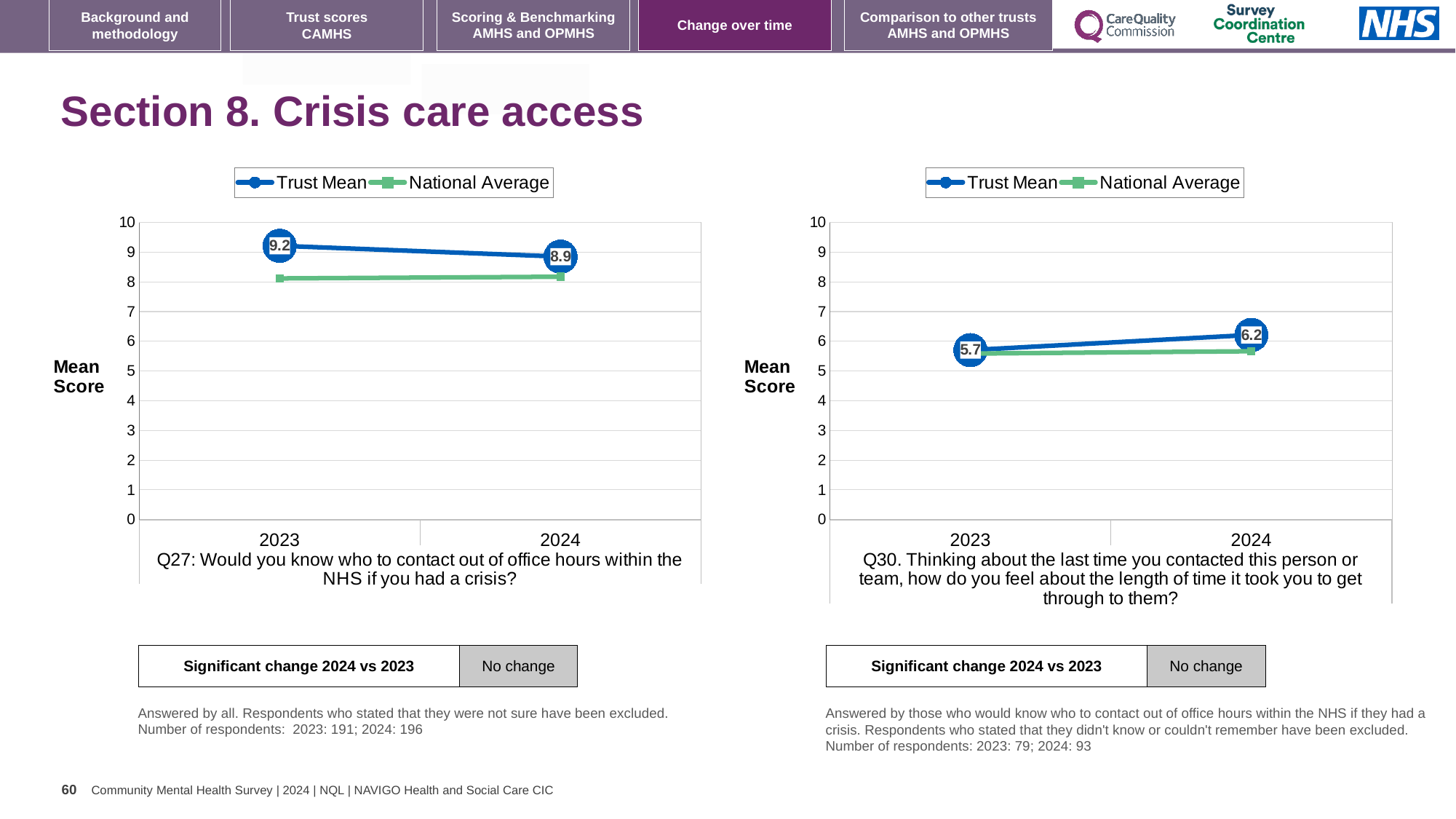
In the left chart (Q27), is the National Average value for 2023 greater or less than 9? less In the left chart (Q27), what is the Trust Mean value for 2023? 9.2 In the right chart (Q30), what is the Trust Mean value for 2023? 5.7 In the left chart (Q27), does the Trust Mean rise or fall from 2023 to 2024? fall In the right chart (Q30), what is the difference between the Trust Mean in 2024 and in 2023? 0.5 What type of chart is the right chart (Q30)? line chart How many years are shown on the x axis of the right chart (Q30)? 2 In the right chart (Q30), what is the Trust Mean value for 2024? 6.2 In the left chart (Q27), by how much did the Trust Mean change from 2023 to 2024? 0.3 In the right chart (Q30), does the Trust Mean rise or fall from 2023 to 2024? rise How many series does the legend of the left chart (Q27) list? 2 In the left chart (Q27), what is the Trust Mean value for 2024? 8.9